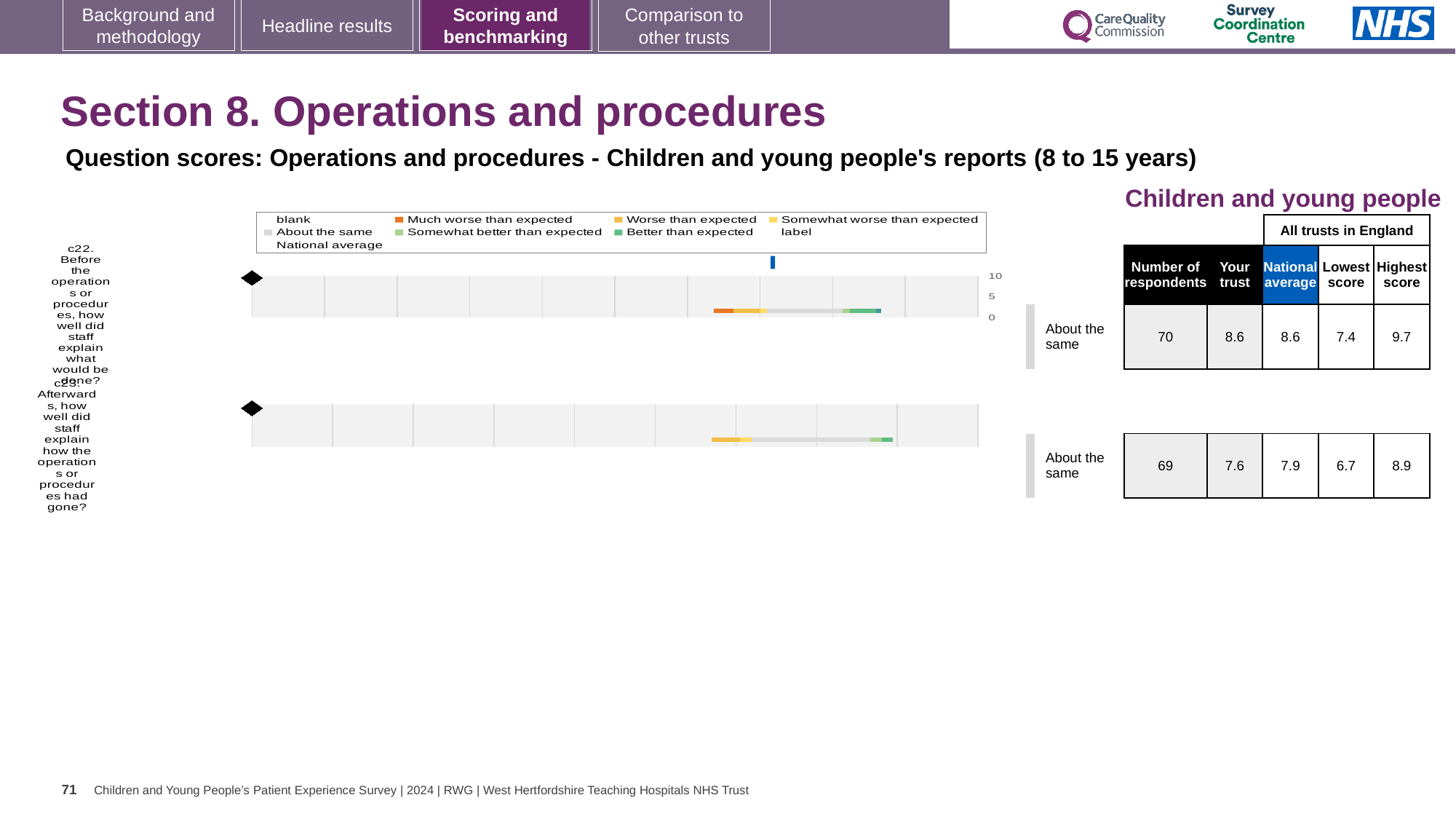
What benchmark category is shown next to the chart for question c22? About the same For question c23, what is the highest score among all trusts in England? 8.9 For question c22, what is the difference between the highest score and the lowest score? 2.3 For question c23, what is the difference between the national average and the 'Your trust' score? 0.3 How many question charts (c22 and c23) are shown on the slide? 2 For question c22, what is the national average score? 8.6 How many entries does the legend above the charts list? 9 For question c23 (Afterwards, how well did staff explain how the operations or procedures had gone?), how many respondents are there? 69 For question c23, which is larger: the 'Your trust' score or the national average? National average Which question has the higher 'Your trust' score, c22 or c23? c22 For question c22 (Before the operations or procedures, how well did staff explain what would be done?), what is the 'Your trust' score? 8.6 What kind of chart is used for question c22 on the slide? bar chart